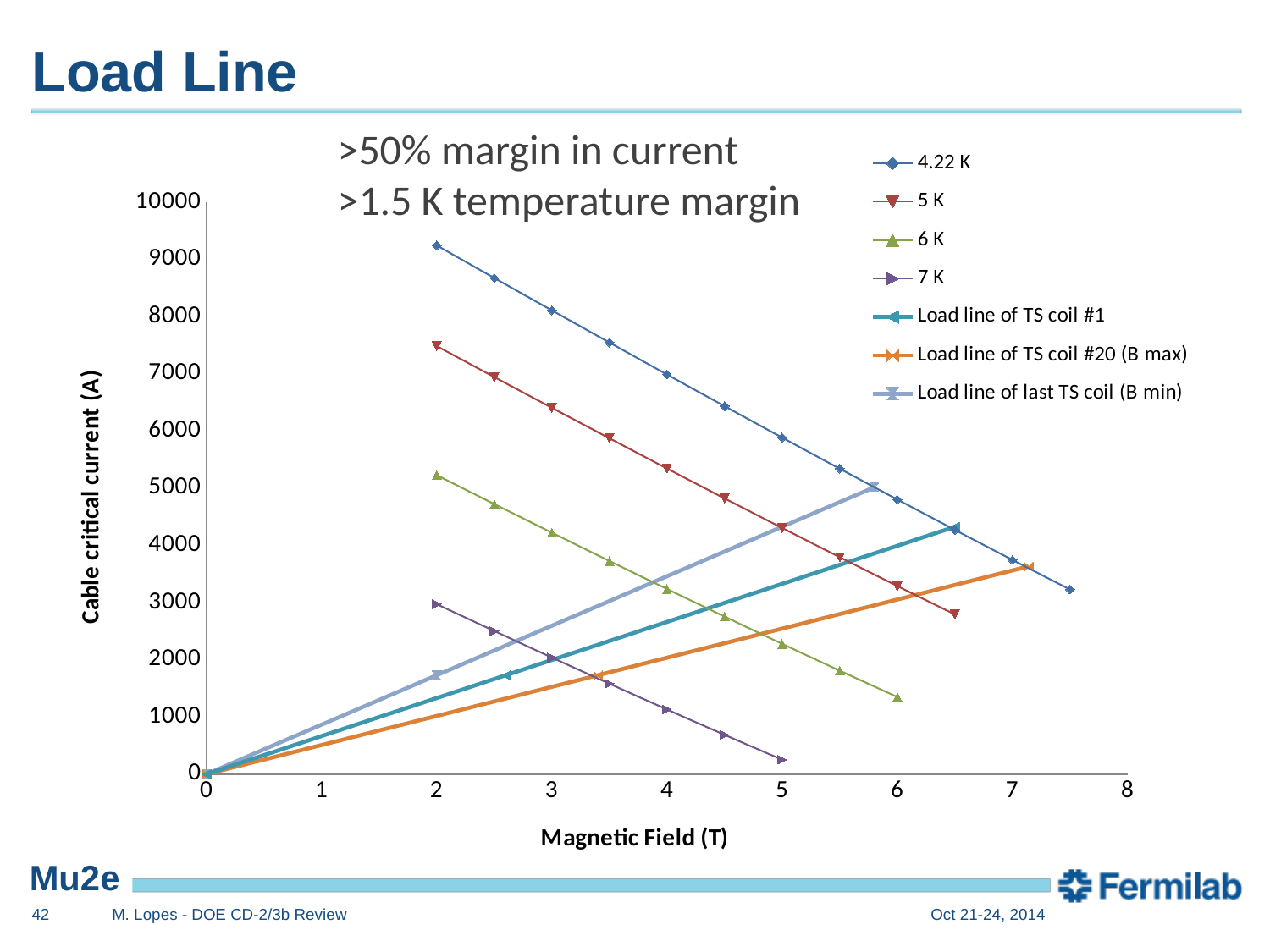
Does the 'Load line of TS coil #1' series rise or fall as the magnetic field increases? rise How many series does the legend list? 7 What is the label of the y axis? Cable critical current (A) Is the value of the 6 K series at 2 T greater or less than 4000? greater What kind of chart is shown on the slide? line chart Is the value of the 4.22 K series at 2 T greater or less than 8000? greater Is the value of the 7 K series at 5 T greater or less than 1000? less Does the 4.22 K series rise or fall as the magnetic field increases? fall Among the temperature series (4.22 K, 5 K, 6 K, 7 K), which has the lowest value at 2 T? 7 K What is the label of the x axis? Magnetic Field (T) At 4 T, which series has the larger value: 4.22 K or 5 K? 4.22 K